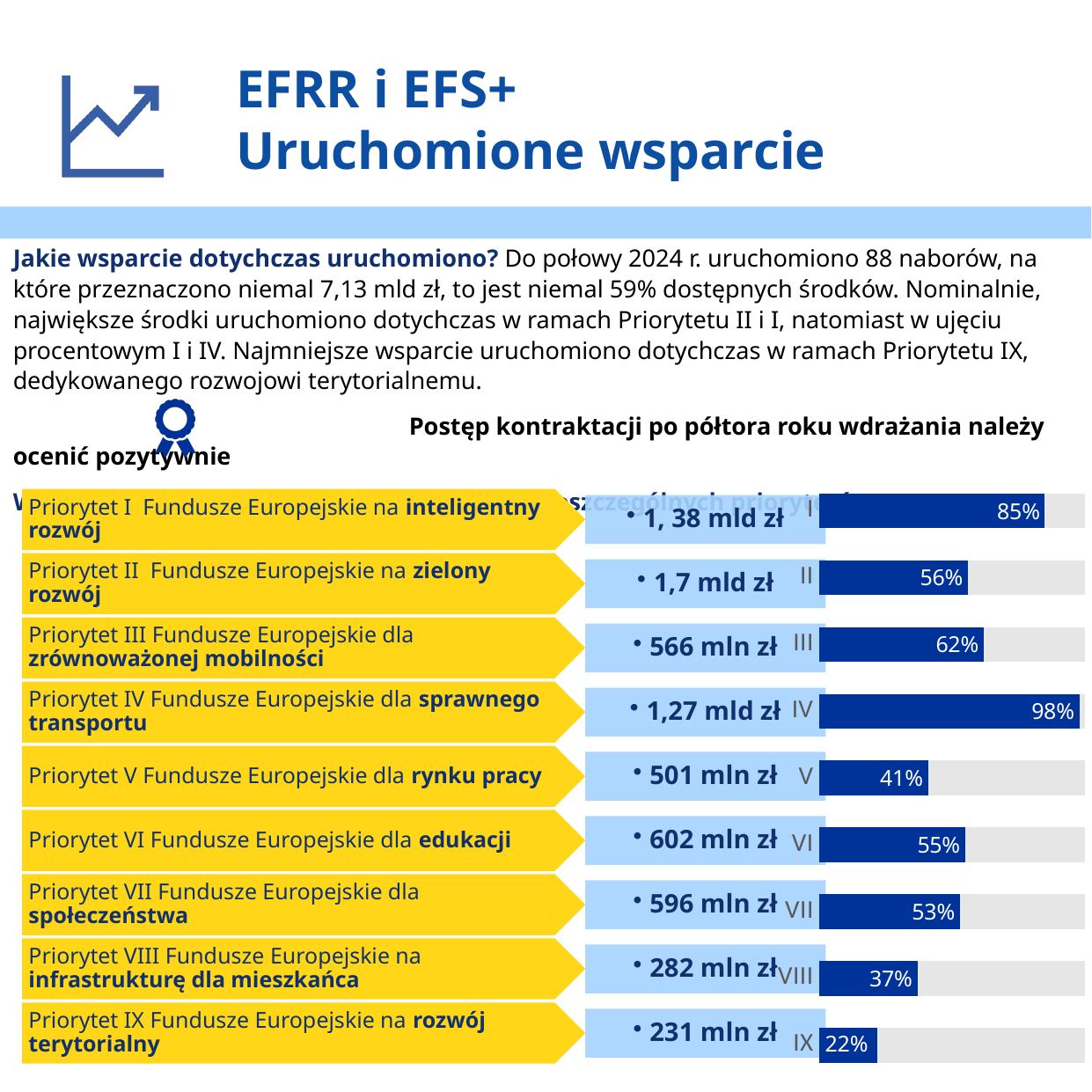
How many priorities are shown as bars in the chart? 9 Which has a higher percentage in the bar chart, Priority VIII or Priority VI? Priority VI What kind of chart is used to show the percentages for the priorities? Bar chart Which has a higher percentage in the bar chart, Priority III or Priority V? Priority III Which priority has the lowest percentage in the bar chart? IX What colour are the filled bars in the percentage chart? Dark blue What percentage is shown for Priority IX in the bar chart? 22% Which priority has the highest percentage in the bar chart? IV What is the difference in percentage points between Priority I and Priority II in the bar chart? 29 What percentage is shown for Priority VII in the bar chart? 53% What is the difference in percentage points between Priority IV and Priority IX in the bar chart? 76 What percentage is shown for Priority IV in the bar chart? 98%